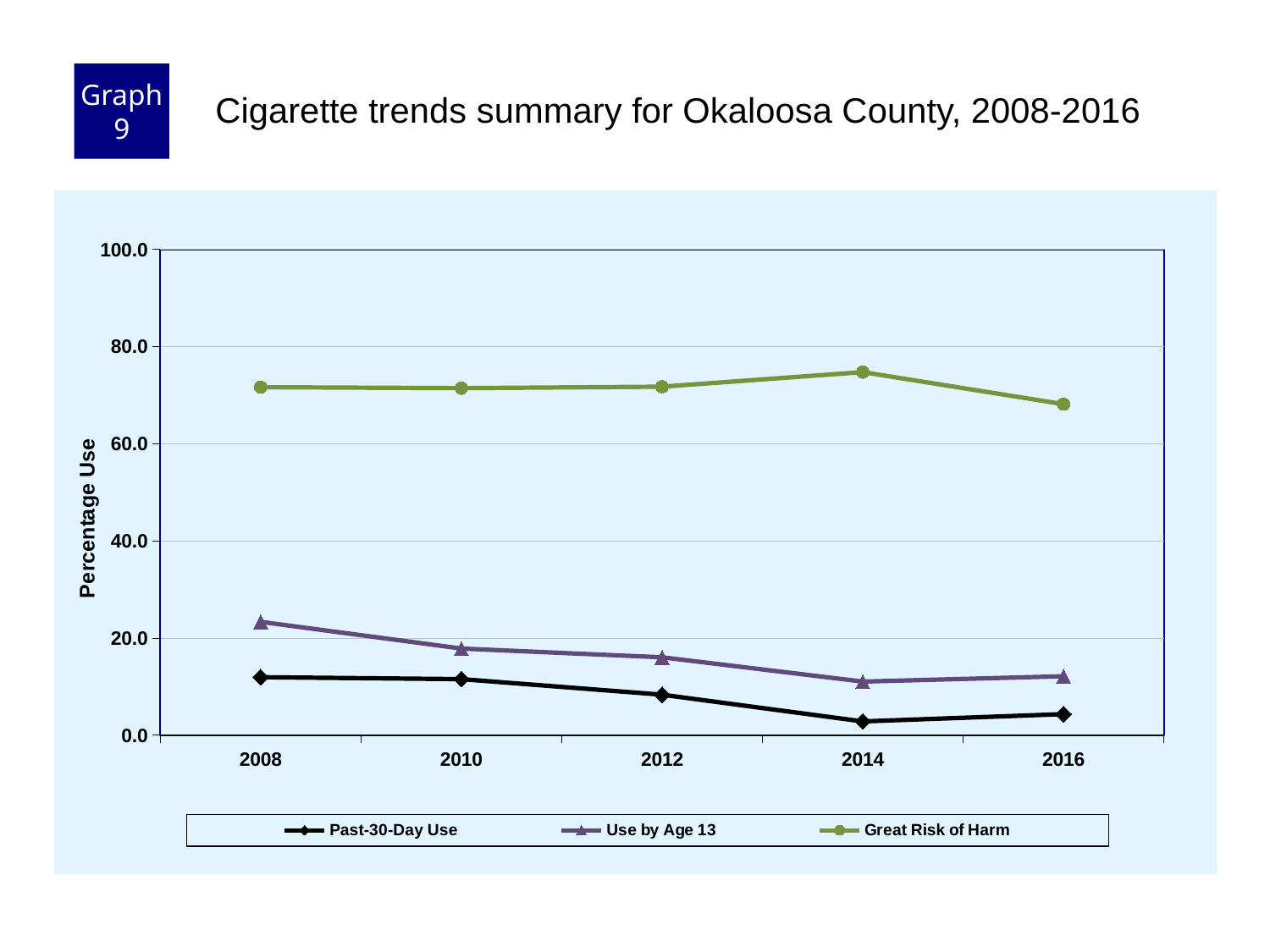
Does Past-30-Day Use rise or fall from 2008 to 2014? Fall How many years are plotted along the x axis? 5 Which series has the highest values across all years? Great Risk of Harm In which year is the Great Risk of Harm value lowest? 2016 Is the Great Risk of Harm value for 2014 greater or less than 80.0? less Is the Past-30-Day Use value for 2014 greater or less than 20.0? less Is the Use by Age 13 value for 2008 greater or less than 20.0? greater In which year is the Great Risk of Harm value highest? 2014 What kind of chart is shown on the slide? Line chart In which year is the Use by Age 13 value highest? 2008 What is the label on the y axis? Percentage Use How many series does the legend list? 3